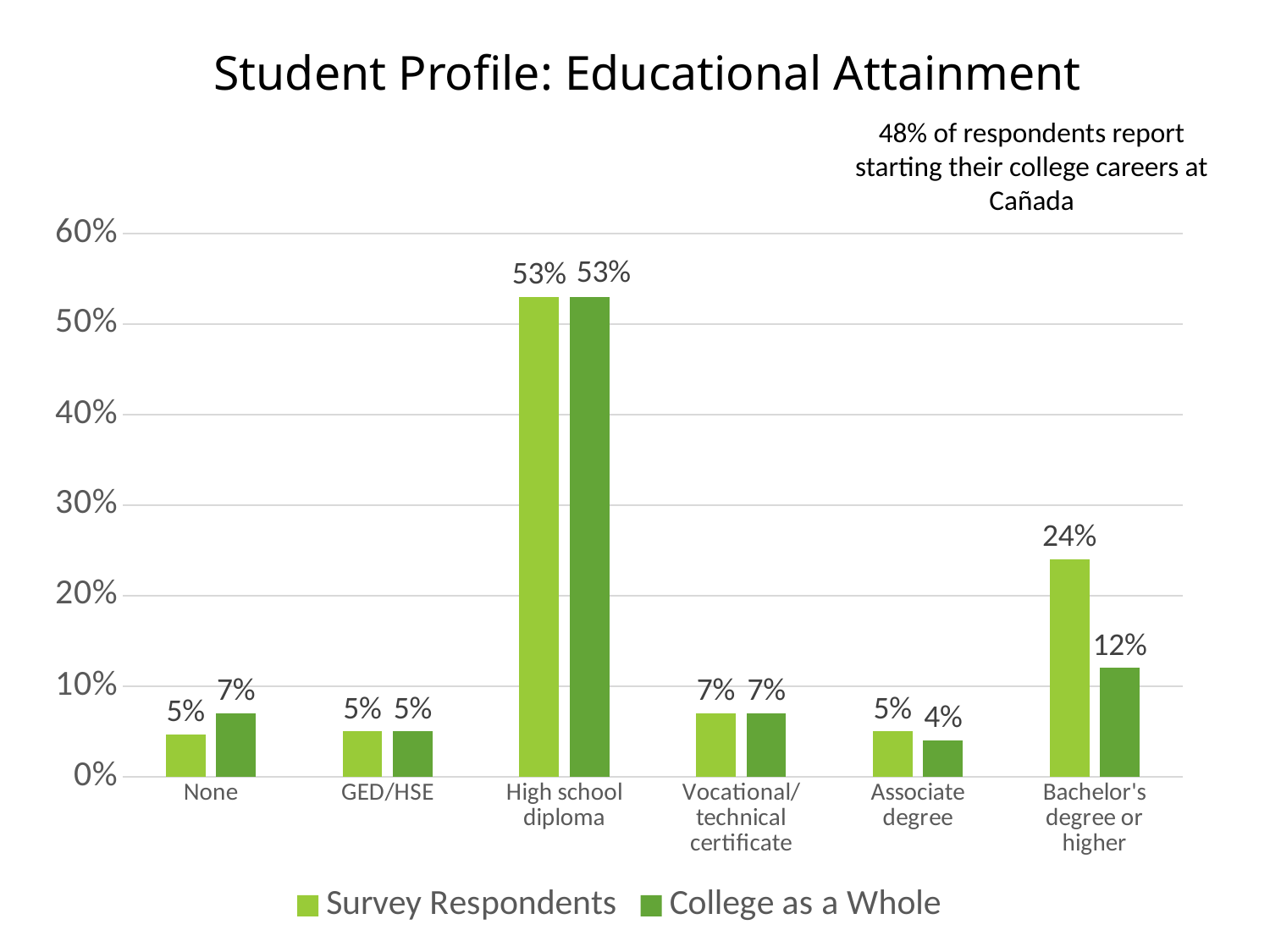
What is the College as a Whole value for Associate degree? 4% What is the College as a Whole value for None? 7% What is the difference between the Survey Respondents and College as a Whole values for Bachelor's degree or higher? 12% How many series does the legend list? 2 Is the Survey Respondents value for High school diploma greater or less than 50%? greater What kind of chart is shown on the slide? bar chart What is the Survey Respondents value for Bachelor's degree or higher? 24% Which is larger for Bachelor's degree or higher: Survey Respondents or College as a Whole? Survey Respondents Which category has the highest Survey Respondents value? High school diploma What is the Survey Respondents value for Vocational/technical certificate? 7% What is the title of the chart? Student Profile: Educational Attainment How many categories are shown on the x axis? 6